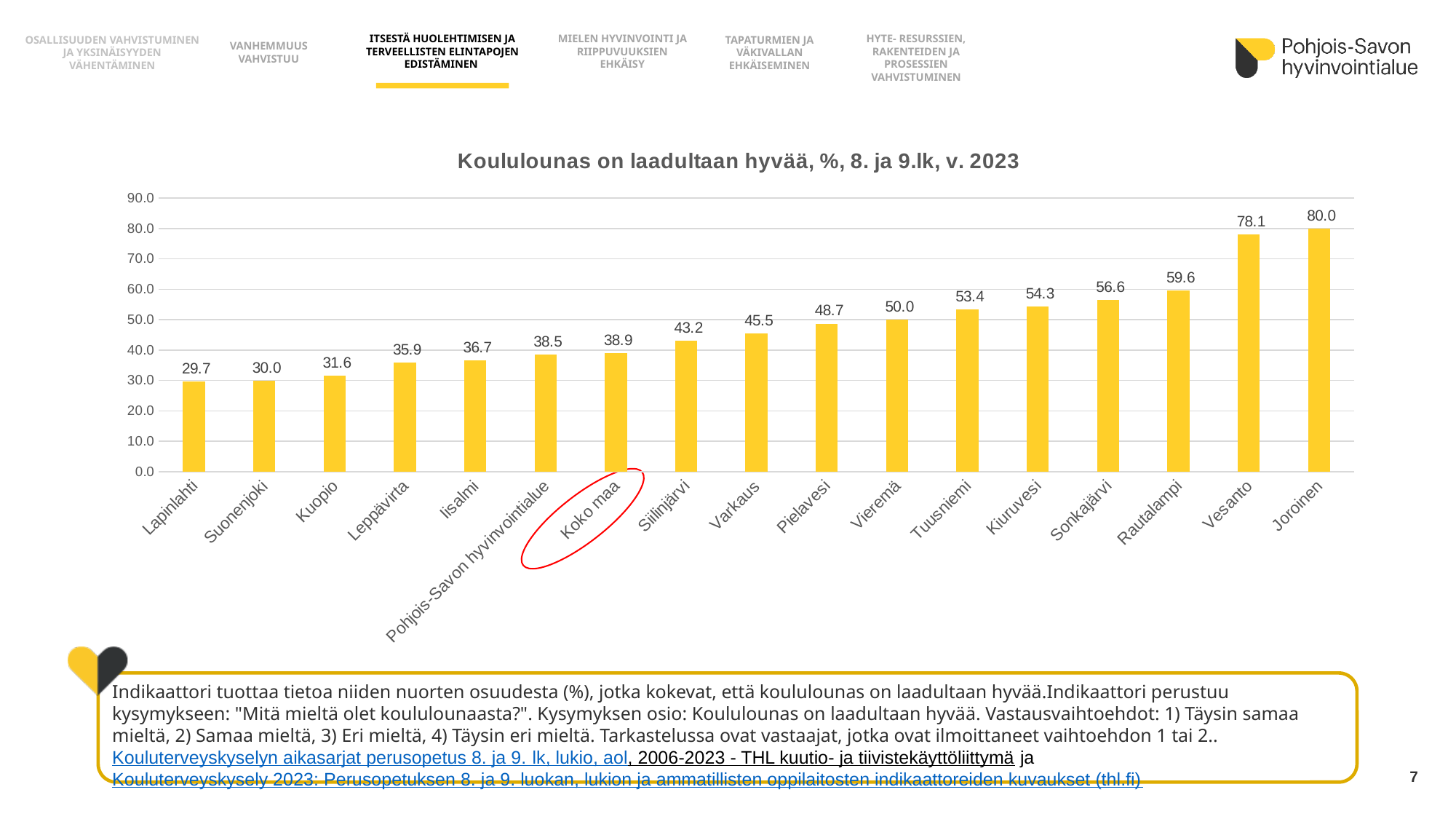
What is the value for Koko maa? 38.9 What is the title of the chart? Koululounas on laadultaan hyvää, %, 8. ja 9.lk, v. 2023 What kind of chart is shown on the slide? Bar chart Which category has the highest value? Joroinen What is the difference between the values for Joroinen and Lapinlahti? 50.3 What is the value for Kuopio? 31.6 Which is larger, the value for Siilinjärvi or the value for Varkaus? Varkaus What is the value for Pohjois-Savon hyvinvointialue? 38.5 What is the value for Vesanto? 78.1 Do the values rise or fall from left to right along the x axis? Rise Which category has the lowest value? Lapinlahti How many categories are shown on the x axis? 17